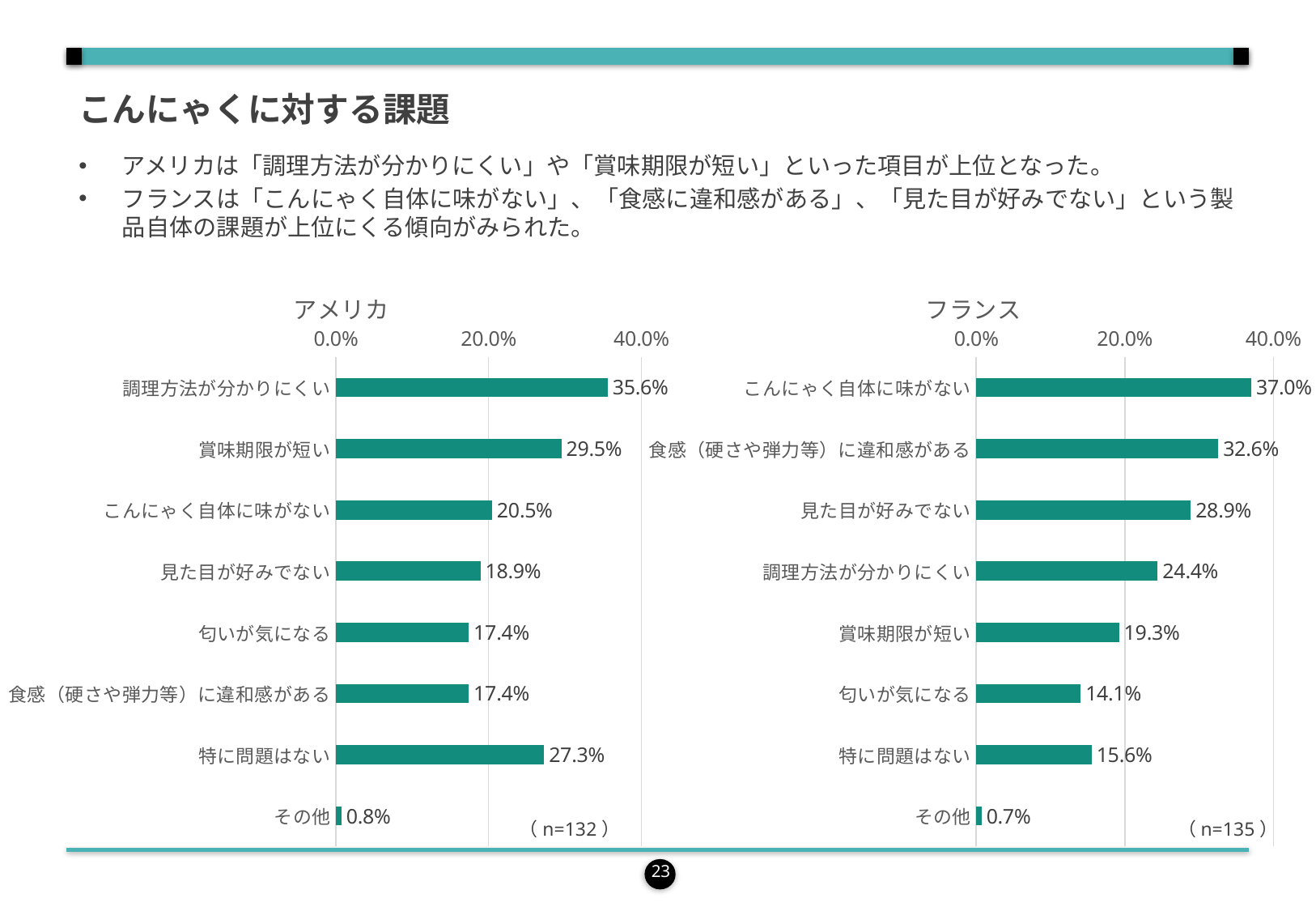
In the フランス chart, which category has the highest value? こんにゃく自体に味がない In the フランス chart, what is the value for 見た目が好みでない? 28.9% What is the sample size (n) shown for the フランス chart? n=135 In the フランス chart, what is the difference between こんにゃく自体に味がない and 食感（硬さや弾力等）に違和感がある? 4.4% Is the value for こんにゃく自体に味がない in the アメリカ chart greater or less than 20.0%? greater In the アメリカ chart, what is the difference between 賞味期限が短い and 特に問題はない? 2.2% In the アメリカ chart, which category has the lowest value? その他 In the アメリカ chart, what is the value for 調理方法が分かりにくい? 35.6% What kind of chart is the フランス chart? bar chart What is the title of the chart on the left? アメリカ In the フランス chart, which is larger: 賞味期限が短い or 特に問題はない? 賞味期限が短い How many categories does the アメリカ chart show? 8